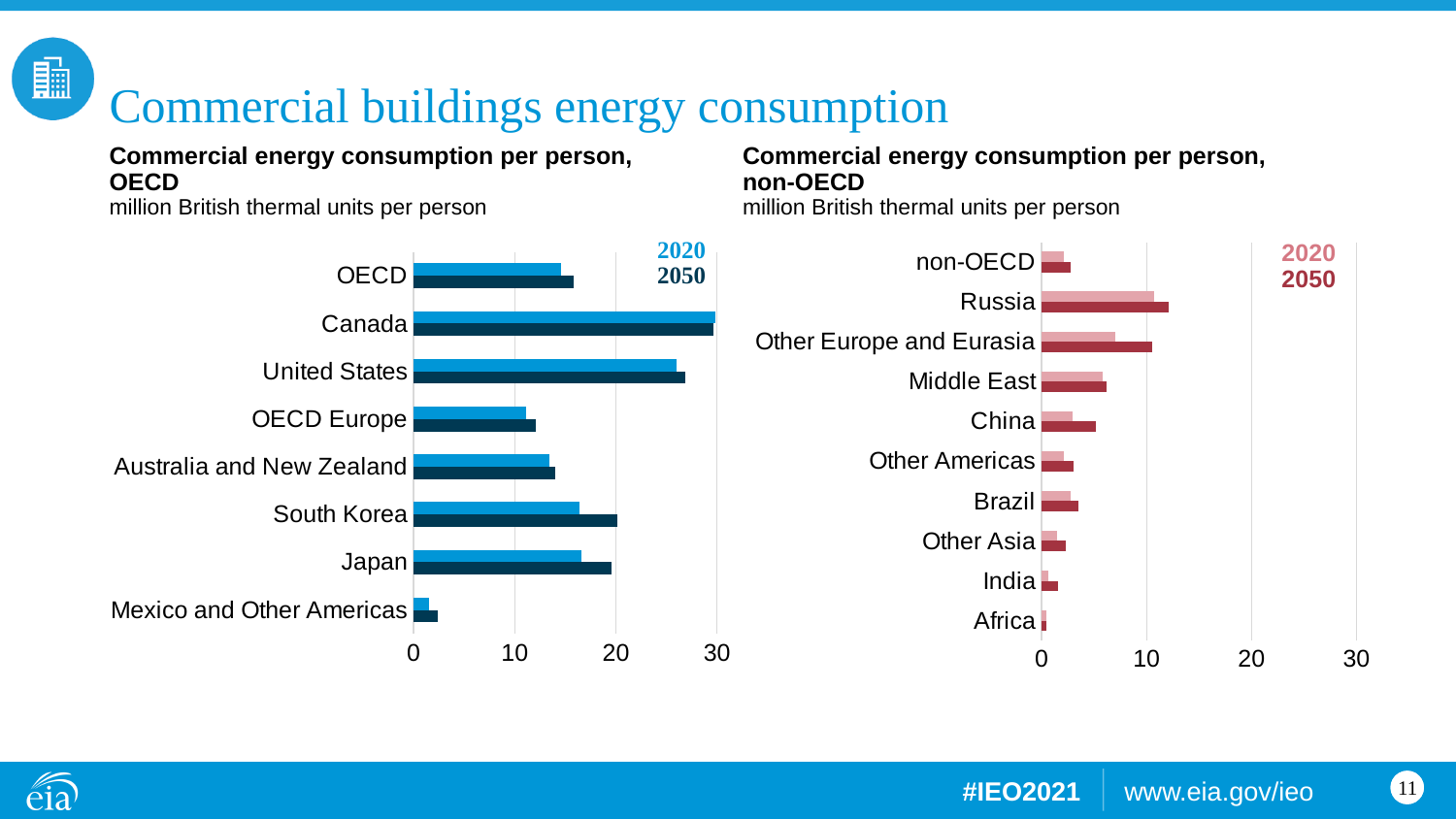
On the 'Commercial energy consumption per person, non-OECD' chart, which category has the highest value? Russia What unit is given under the title of the 'Commercial energy consumption per person, non-OECD' chart? million British thermal units per person On the 'Commercial energy consumption per person, OECD' chart, is the 2020 value for Canada greater or less than 20? greater On the 'Commercial energy consumption per person, non-OECD' chart, is the 2050 value for China greater or less than 10? less On the 'Commercial energy consumption per person, non-OECD' chart, which is larger in 2050: Other Europe and Eurasia or Middle East? Other Europe and Eurasia On the 'Commercial energy consumption per person, OECD' chart, which category has the lowest value? Mexico and Other Americas On the 'Commercial energy consumption per person, non-OECD' chart, which category has the lowest value? Africa On the 'Commercial energy consumption per person, OECD' chart, which category has the highest value? Canada How many categories are shown on the 'Commercial energy consumption per person, OECD' chart? 8 How many categories are shown on the 'Commercial energy consumption per person, non-OECD' chart? 10 What type of chart is the 'Commercial energy consumption per person, OECD' chart? bar chart How many series does the legend list on the 'Commercial energy consumption per person, OECD' chart? 2